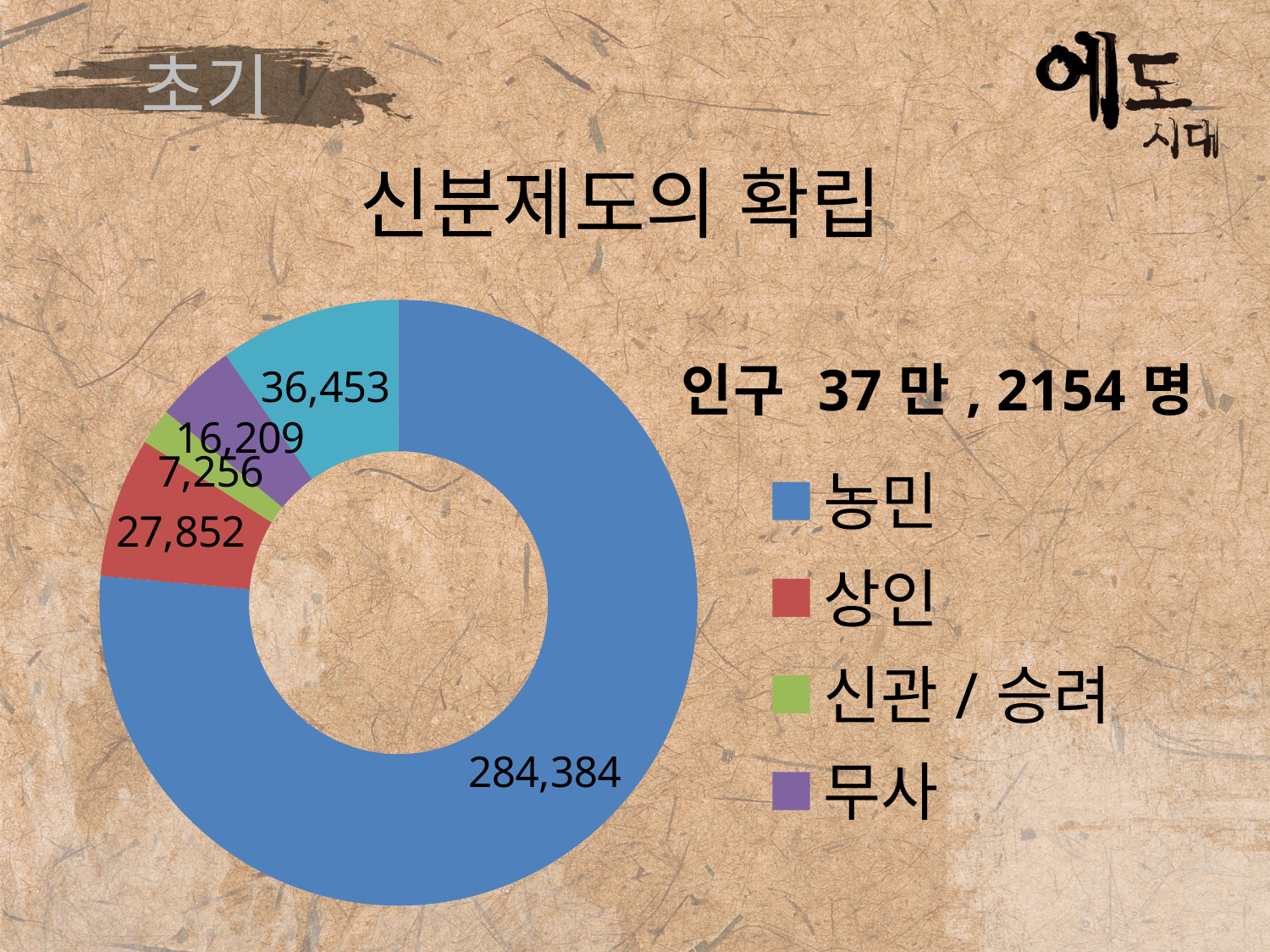
What kind of chart is shown on the slide? Doughnut (pie) chart What is the difference between the values for 상인 and 무사? 11,643 How many slices does the doughnut chart have? 5 What is the value shown for 신관 / 승려 in the doughnut chart? 7,256 What is the value shown for 무사 in the doughnut chart? 16,209 What is the value shown for 상인 in the doughnut chart? 27,852 What is the value shown for 농민 in the doughnut chart? 284,384 What colour represents 농민 in the chart? Blue Which is larger, the value for 상인 or the value for 무사? 상인 How many entries does the legend list? 4 Which category has the smallest slice in the doughnut chart? 신관 / 승려 Which category has the largest slice in the doughnut chart? 농민